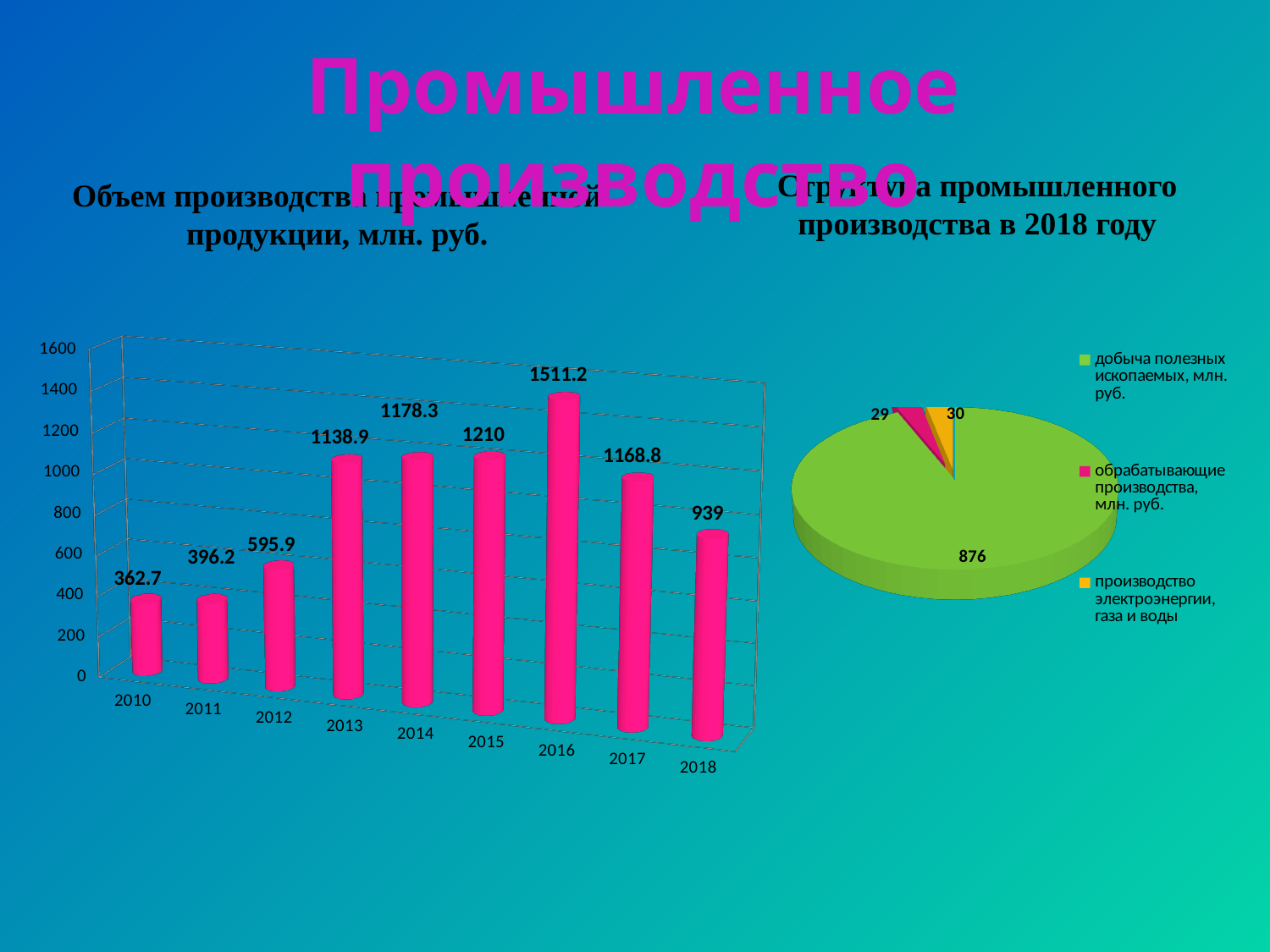
What kind of chart is the left chart on the slide? bar chart In the left bar chart, what is the value for 2010? 362.7 In the pie chart 'Структура промышленного производства в 2018 году', what is the value for 'добыча полезных ископаемых, млн. руб.'? 876 In the left bar chart, which year has the highest value? 2016 In the left bar chart, what is the difference between the values for 2016 and 2017? 342.4 In the left bar chart, which year has the larger value, 2013 or 2014? 2014 In the left bar chart, do the values rise or fall from 2010 to 2016? rise What kind of chart is the chart titled 'Структура промышленного производства в 2018 году'? pie chart In the left bar chart, what is the value for 2016? 1511.2 In the left bar chart, which year has the lowest value? 2010 How many entries does the legend of the pie chart 'Структура промышленного производства в 2018 году' list? 3 How many years are shown in the left bar chart? 9